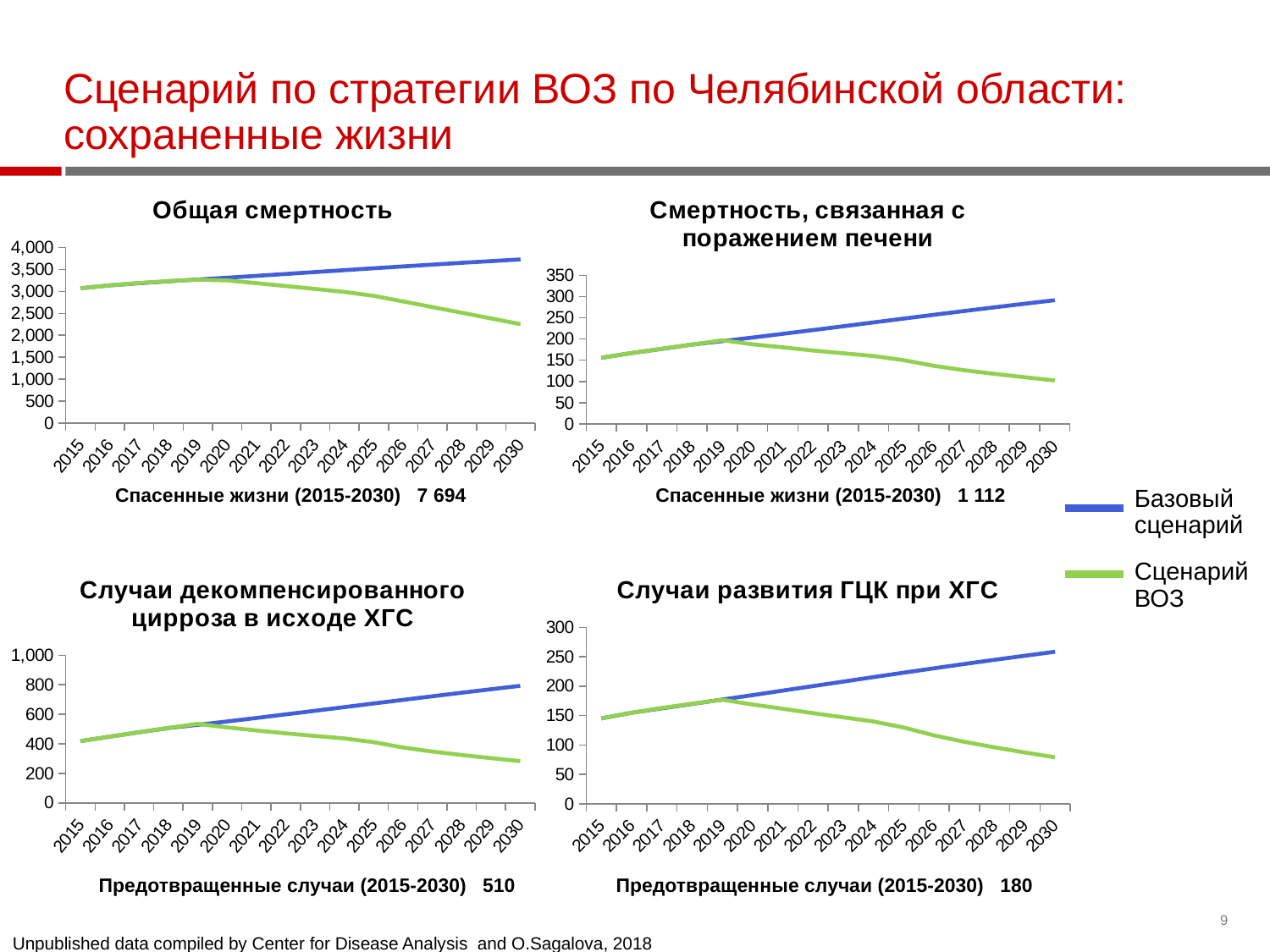
In the 'Общая смертность' chart, is the value for 'Сценарий ВОЗ' in 2030 greater or less than 2,500? less In the 'Смертность, связанная с поражением печени' chart, does the 'Сценарий ВОЗ' line rise or fall from 2020 to 2030? fall In the 'Общая смертность' chart, how many years are shown on the x axis? 16 In the 'Общая смертность' chart, is the value for 'Базовый сценарий' in 2030 greater or less than 3,500? greater In the 'Случаи декомпенсированного цирроза в исходе ХГС' chart, which series has the larger value in 2030, 'Базовый сценарий' or 'Сценарий ВОЗ'? Базовый сценарий Which colour is used for the 'Сценарий ВОЗ' series in the legend? green In the 'Смертность, связанная с поражением печени' chart, is the value for 'Базовый сценарий' in 2030 greater or less than 250? greater In the 'Случаи развития ГЦК при ХГС' chart, does the 'Базовый сценарий' line rise or fall from 2015 to 2030? rise How many series does the legend list for the charts on the slide? 2 What kind of chart is the 'Общая смертность' chart? line chart